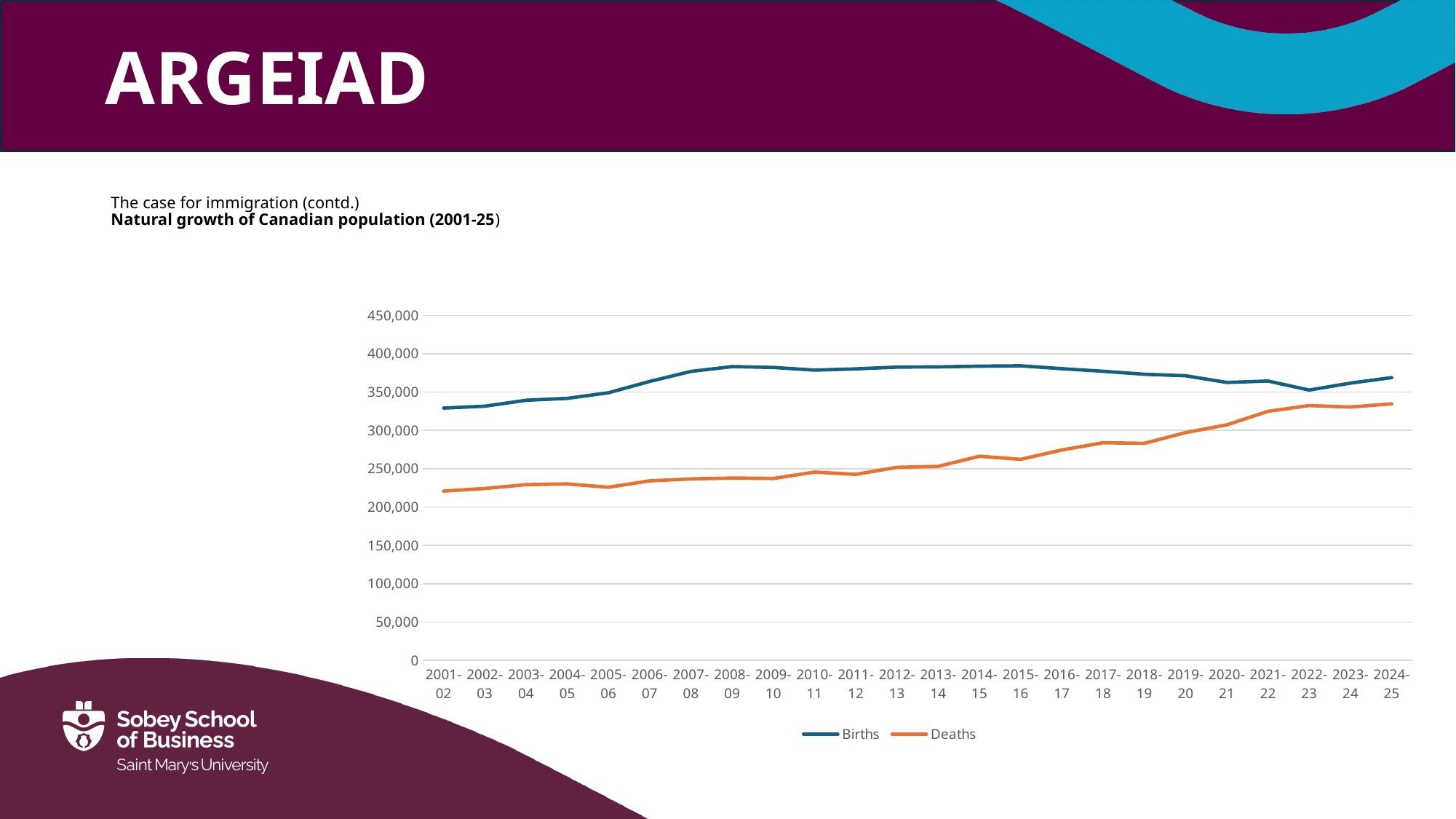
Is the value for Births in 2001-02 greater or less than 300,000? greater Do the values for Deaths generally rise or fall from 2001-02 to 2024-25? rise In which year period is the value for Births lowest? 2001-02 What kind of chart is shown on the slide? line chart In which year period is the value for Deaths lowest? 2001-02 Is the value for Deaths in 2001-02 greater or less than 250,000? less In 2024-25, which series has the larger value, Births or Deaths? Births Is the value for Deaths in 2024-25 greater or less than 300,000? greater In which year period is the value for Deaths highest? 2024-25 Which two series are shown in the legend? Births and Deaths How many year periods are plotted along the x axis? 24 How many series does the legend list? 2